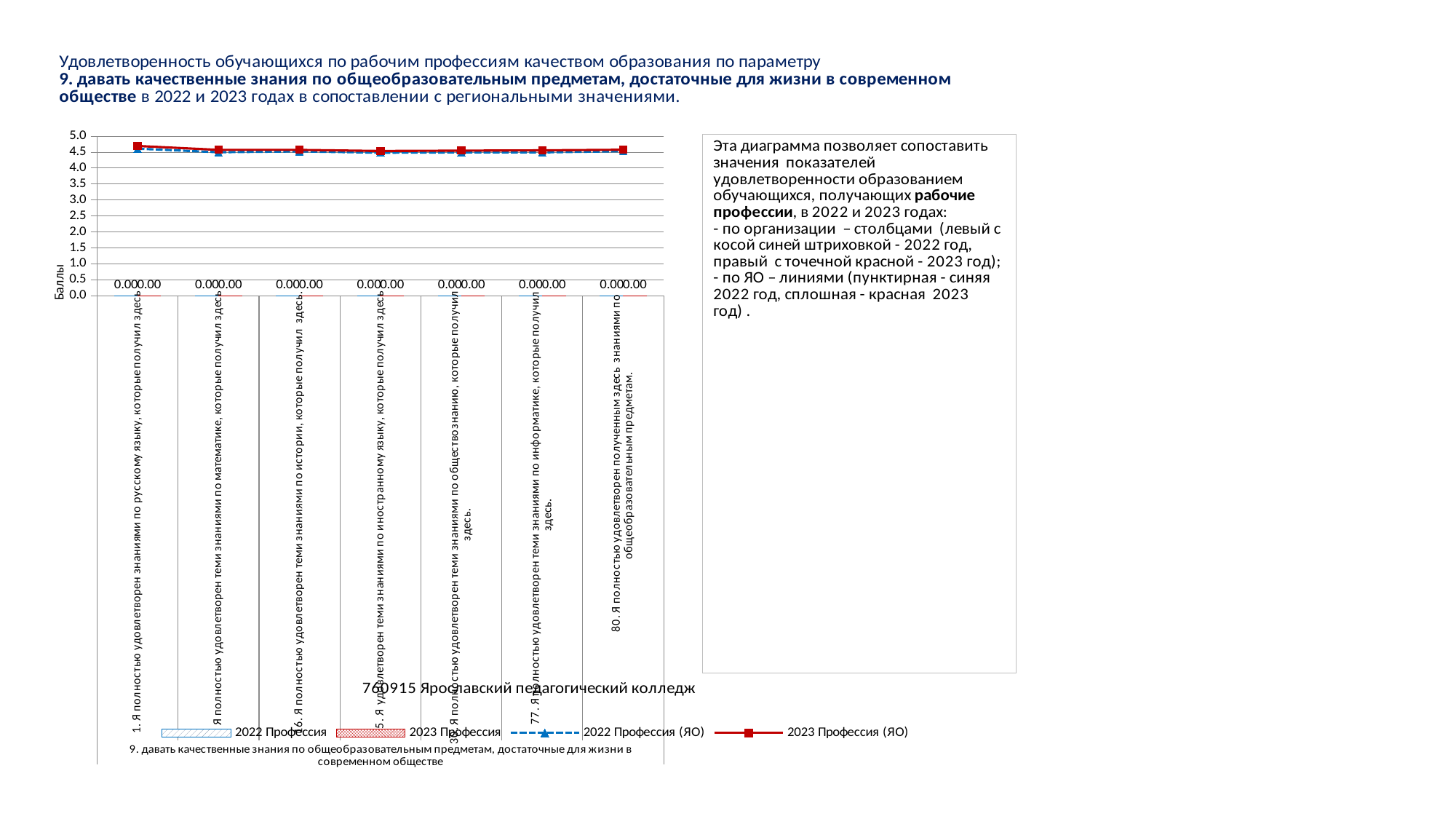
How many series does the chart legend list? 4 What value is printed for the 2022 Профессия bar in the category about русский язык? 0.00 Which category has the highest value on the 2023 Профессия (ЯО) line? 1. Я полностью удовлетворен знаниями по русскому языку, которые получил здесь How many categories are plotted along the x axis of the chart? 7 Is the 2022 Профессия (ЯО) value for the category about информатика greater or less than 3.0? greater What is the title of the vertical axis of the chart? Баллы Is the 2023 Профессия (ЯО) value for the category about русский язык greater or less than 4.0? greater Does the 2023 Профессия (ЯО) line rise or fall from the category about русский язык to the category about математика? fall What is the maximum value shown on the vertical axis of the chart? 5.0 What kind of chart is shown on the slide? A bar chart combined with line series Which is larger for the category about русский язык: the 2023 Профессия bar or the 2023 Профессия (ЯО) line value? 2023 Профессия (ЯО)